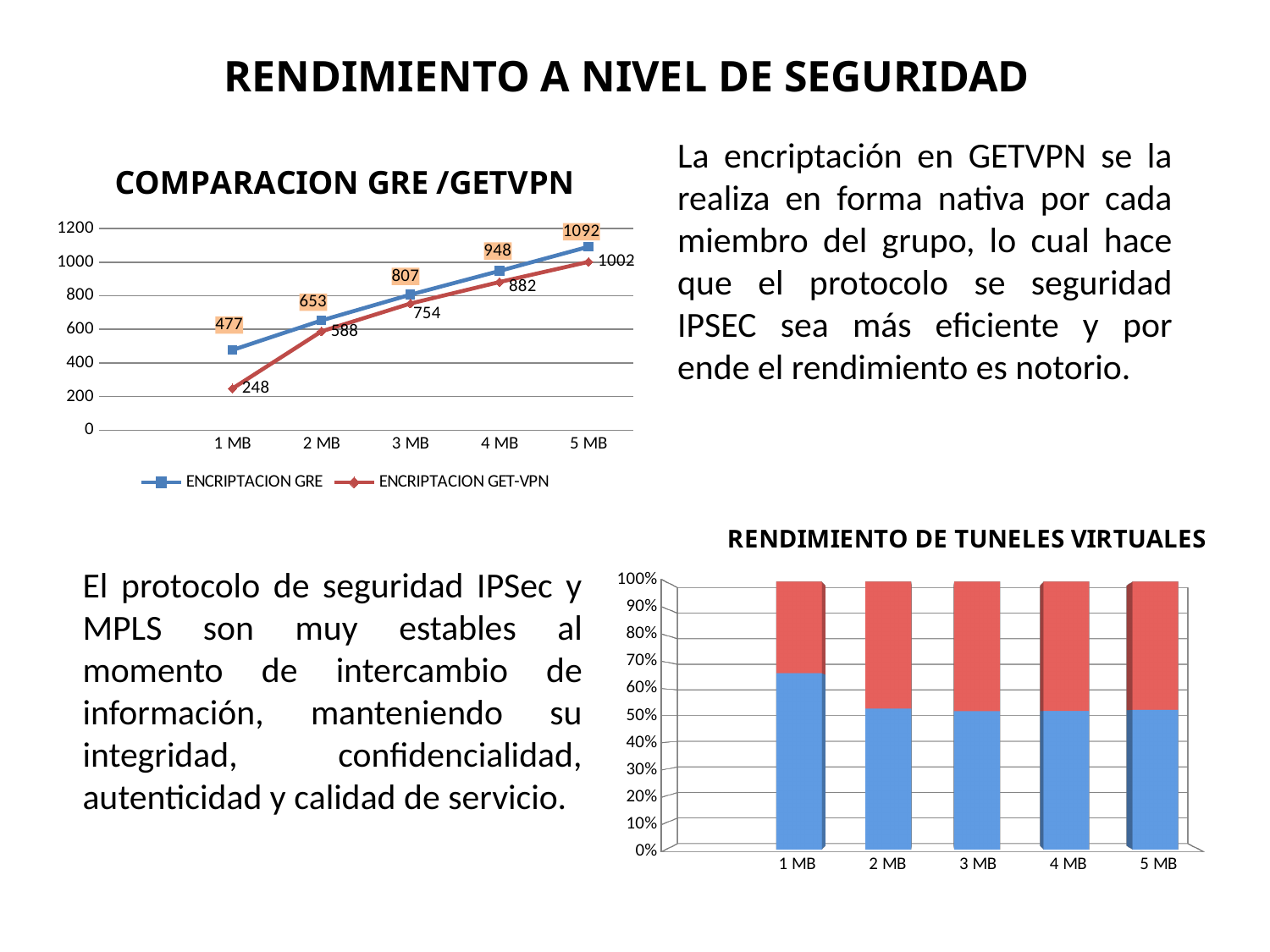
In the RENDIMIENTO DE TUNELES VIRTUALES chart, is the blue portion of the 1 MB bar greater or less than 60%? greater In the COMPARACION GRE /GETVPN chart, do the values for ENCRIPTACION GET-VPN rise or fall from 1 MB to 5 MB? rise In the COMPARACION GRE /GETVPN chart, what is the value for ENCRIPTACION GRE at 3 MB? 807 In the COMPARACION GRE /GETVPN chart, at which file size is ENCRIPTACION GRE highest? 5 MB In the COMPARACION GRE /GETVPN chart, at which file size is ENCRIPTACION GET-VPN lowest? 1 MB What kind of chart is the COMPARACION GRE /GETVPN chart? line chart In the COMPARACION GRE /GETVPN chart, how many series does the legend list? 2 In the COMPARACION GRE /GETVPN chart, what is the value for ENCRIPTACION GET-VPN at 5 MB? 1002 In the RENDIMIENTO DE TUNELES VIRTUALES chart, how many categories are shown on the x axis? 5 In the COMPARACION GRE /GETVPN chart, what is the value for ENCRIPTACION GET-VPN at 1 MB? 248 In the COMPARACION GRE /GETVPN chart, which series has the larger value at 4 MB? ENCRIPTACION GRE In the COMPARACION GRE /GETVPN chart, what is the difference between ENCRIPTACION GRE and ENCRIPTACION GET-VPN at 1 MB? 229